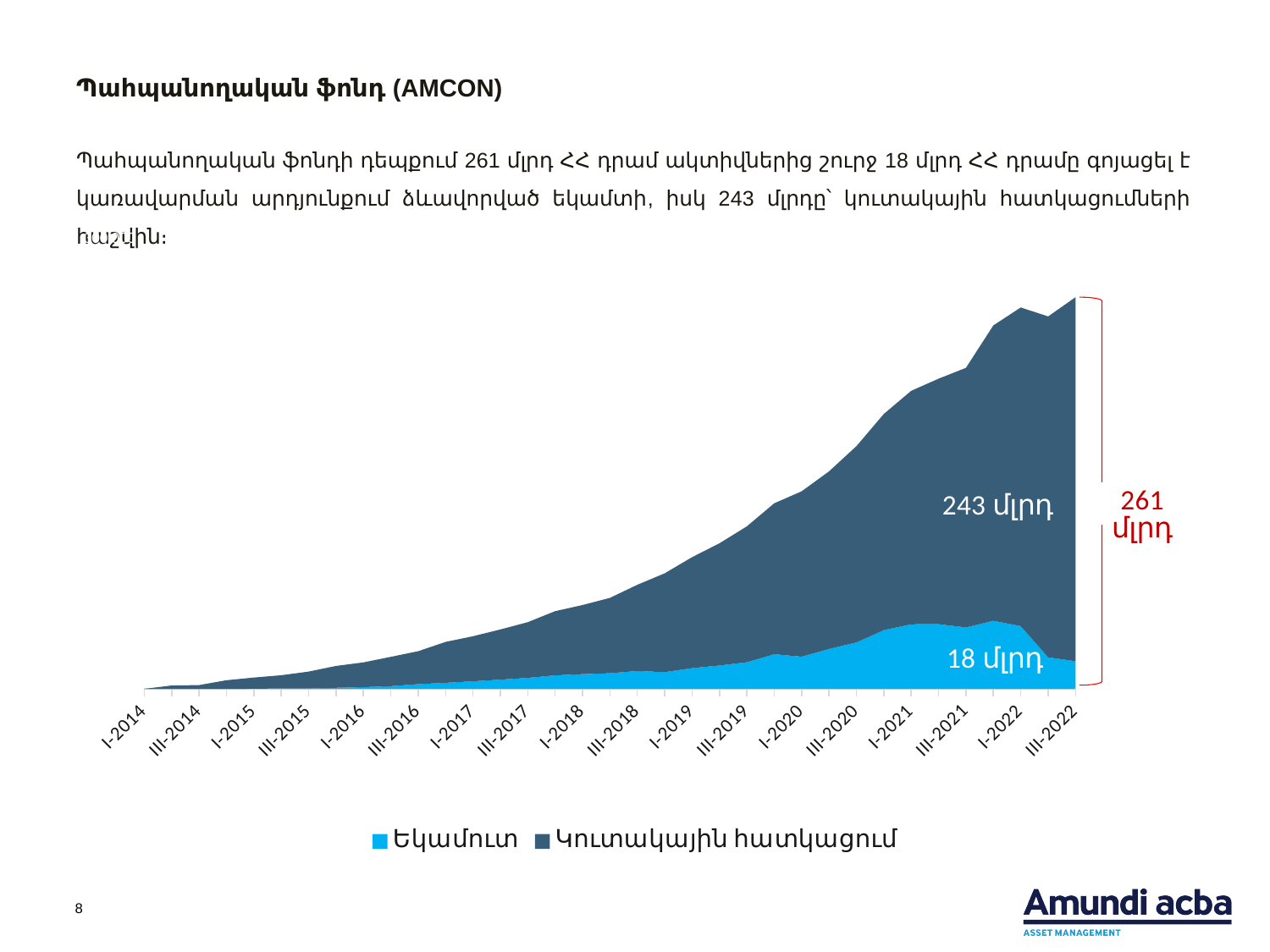
What is the first period label on the x axis? I-2014 Do the total values rise or fall along the x axis from I-2014 to III-2022? Rise Which series is shown in light blue according to the legend? Եկամուտ What is the total of the two series at III-2022, as labelled on the chart? 261 մլրդ What is the difference between the labelled values for Կուտակային հատկացում (243 մլրդ) and Եկամուտ (18 մլրդ)? 225 մլրդ What is the labelled value for Եկամուտ at the end of the chart (III-2022)? 18 մլրդ How many series does the chart legend list? 2 What is the labelled value for Կուտակային հատկացում at the end of the chart (III-2022)? 243 մլրդ What kind of chart is shown on the slide? Area chart Which series is larger at III-2022, Եկամուտ or Կուտակային հատկացում? Կուտակային հատկացում